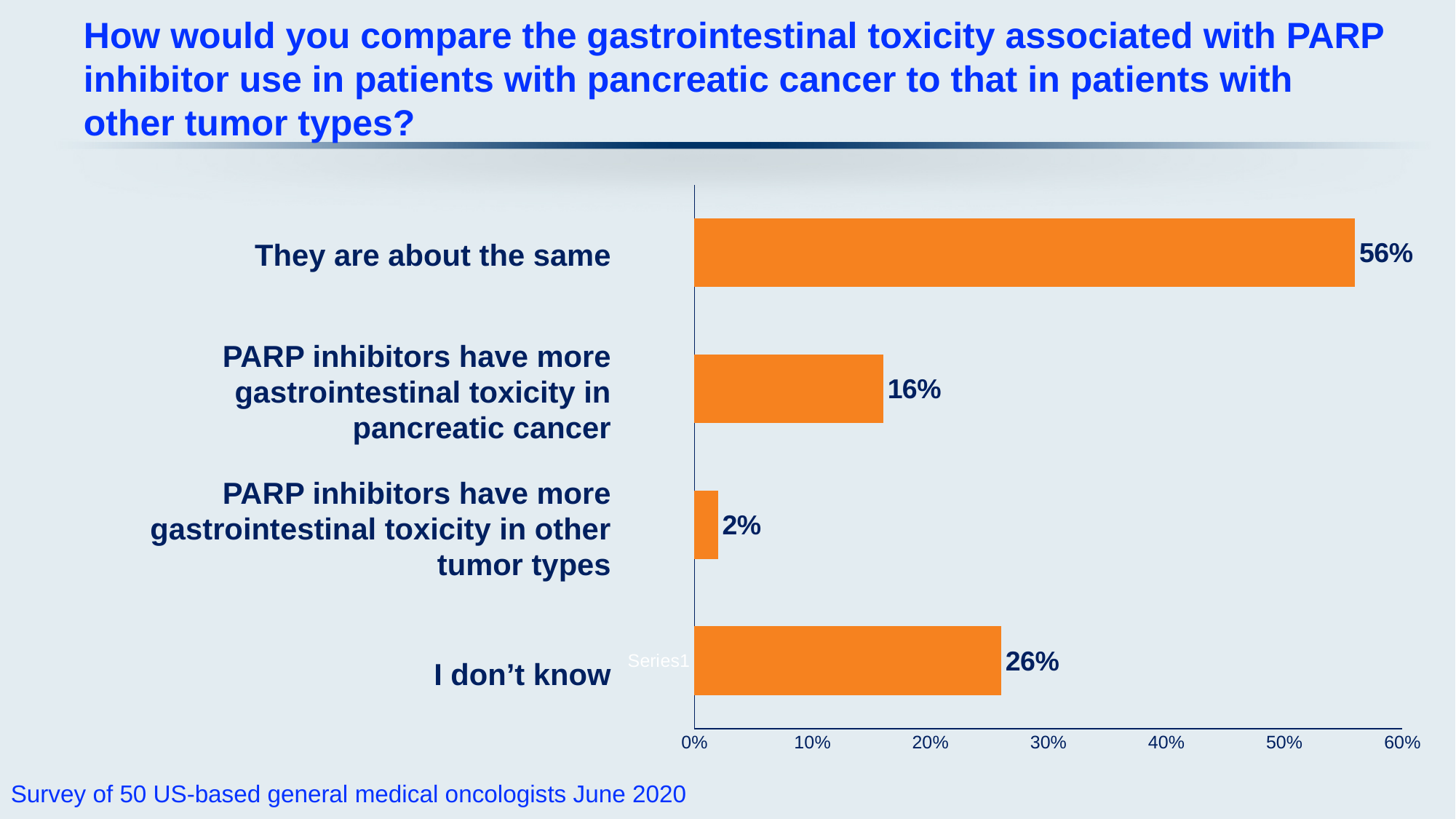
What percentage of respondents answered "I don't know"? 26% What is the difference in percentage points between "They are about the same" and "I don't know"? 30 What type of chart is shown on the slide? Bar chart What percentage of respondents said PARP inhibitors have more gastrointestinal toxicity in pancreatic cancer? 16% Is the value for "They are about the same" greater or less than 50%? greater What percentage of respondents said "They are about the same"? 56% Which response option has the highest percentage? They are about the same How many response categories are shown in the chart? 4 What percentage of respondents said PARP inhibitors have more gastrointestinal toxicity in other tumor types? 2% Which is larger: the percentage for "I don't know" or the percentage for PARP inhibitors having more gastrointestinal toxicity in pancreatic cancer? I don't know What is the maximum value shown on the horizontal axis? 60% Which response option has the lowest percentage? PARP inhibitors have more gastrointestinal toxicity in other tumor types